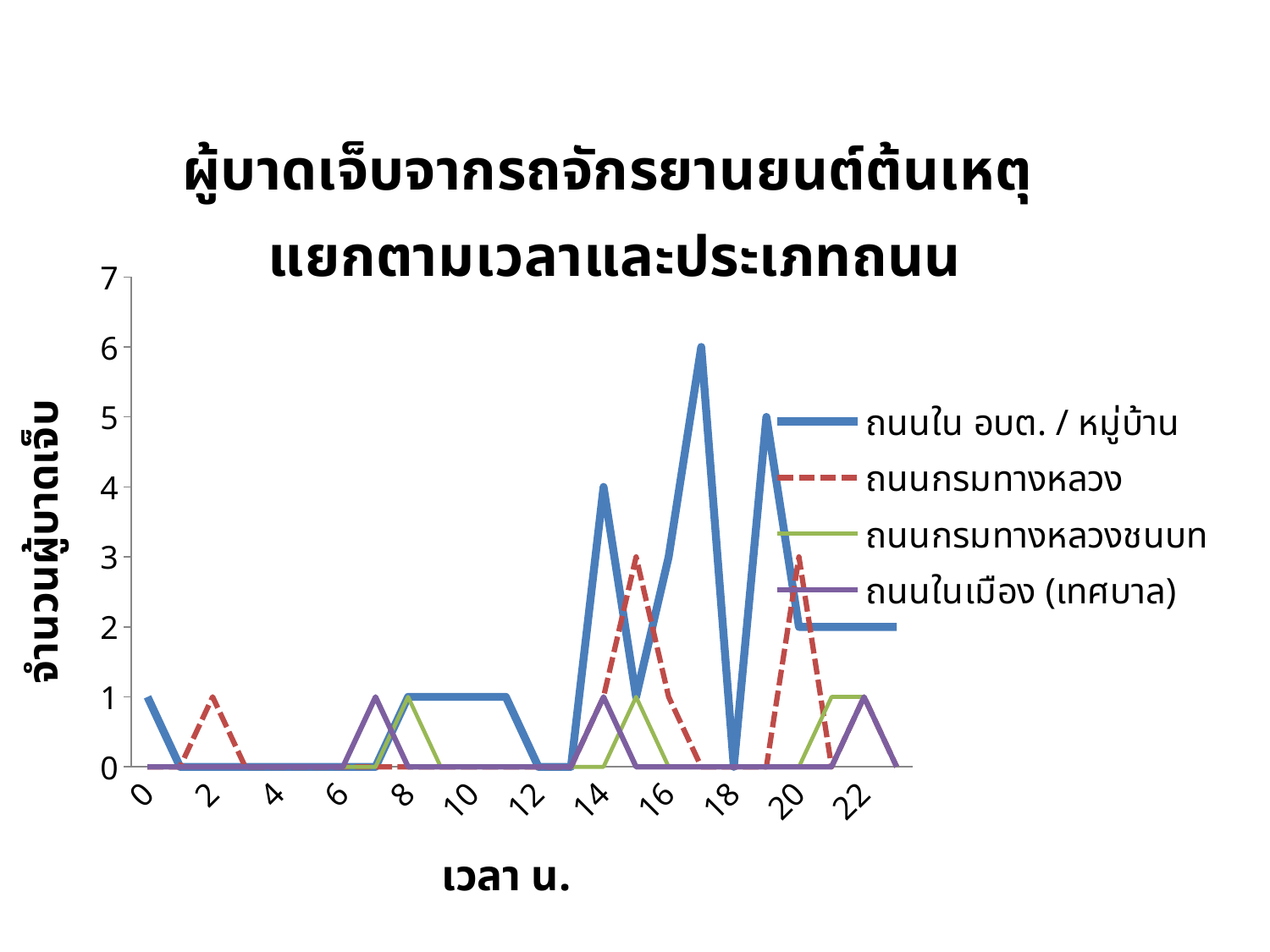
What is the highest value reached by the ถนนใน อบต. / หมู่บ้าน series? 6 What is the value of the ถนนใน อบต. / หมู่บ้าน series at hour 22? 2 How many series does the legend list? 4 What is the title of the horizontal axis? เวลา น. What is the highest value reached by the ถนนกรมทางหลวงชนบท series? 1 What is the difference between the peak value of ถนนใน อบต. / หมู่บ้าน and the peak value of ถนนกรมทางหลวง? 3 What is the highest value reached by the ถนนกรมทางหลวง series? 3 What kind of chart is shown on the slide? line chart What is the title of the vertical axis? จำนวนผู้บาดเจ็บ Which series reaches the highest value on the chart? ถนนใน อบต. / หมู่บ้าน At hour 14, which series has the larger value: ถนนใน อบต. / หมู่บ้าน or ถนนกรมทางหลวง? ถนนใน อบต. / หมู่บ้าน What is the value of the ถนนใน อบต. / หมู่บ้าน series at hour 0? 1